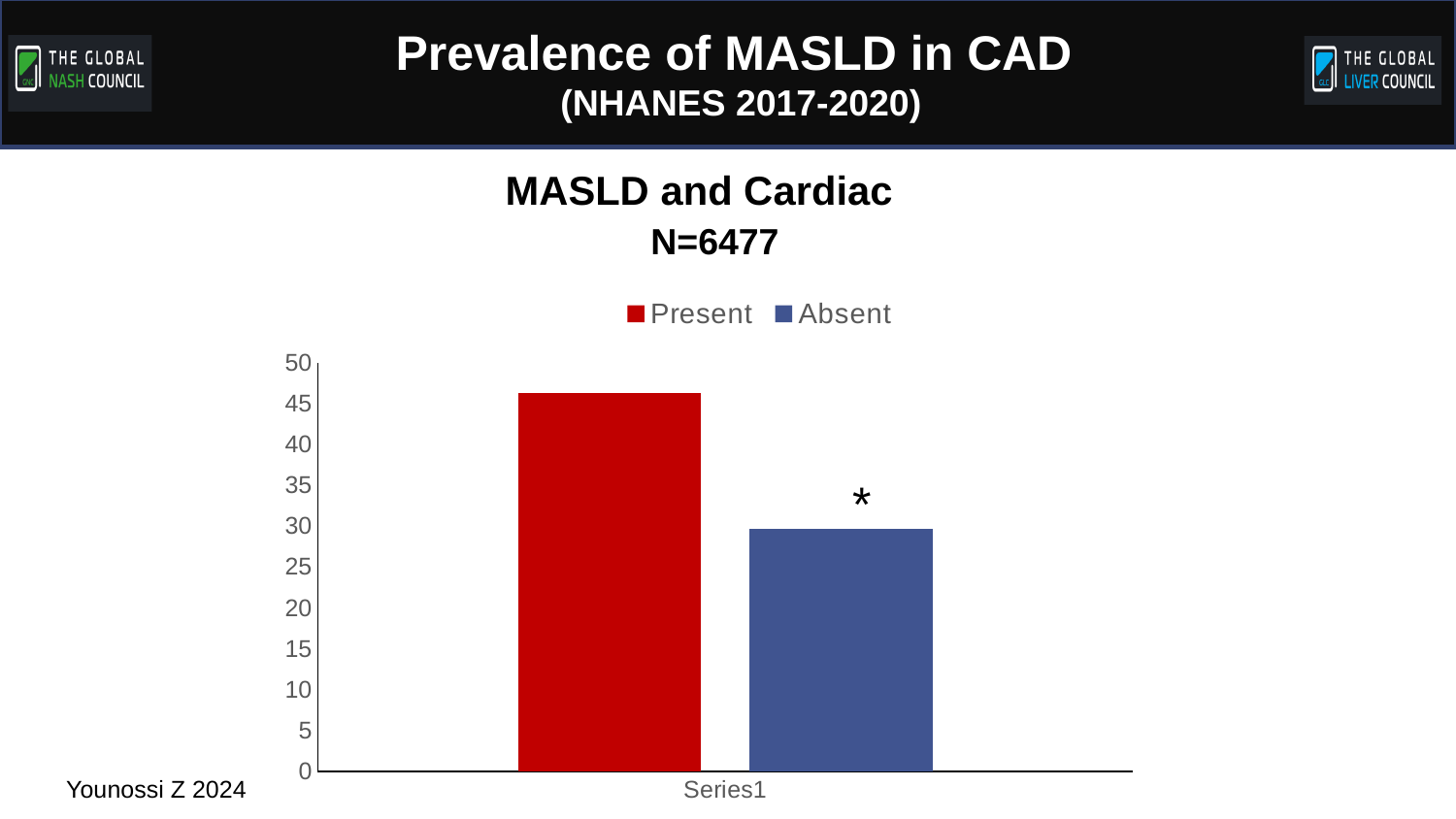
What colour is the bar for the Absent series? blue Is the value for Present greater or less than 50? less What is the title shown above the chart? MASLD and Cardiac N=6477 Is the value for Absent greater or less than 35? less What kind of chart is shown on the slide? bar chart How many series does the legend list? 2 Which series has the shorter bar, Present or Absent? Absent Is the value for Present greater or less than 45? greater Is the bar for Present larger or smaller than the bar for Absent? larger What is the highest value shown on the vertical axis? 50 Which series has the taller bar, Present or Absent? Present